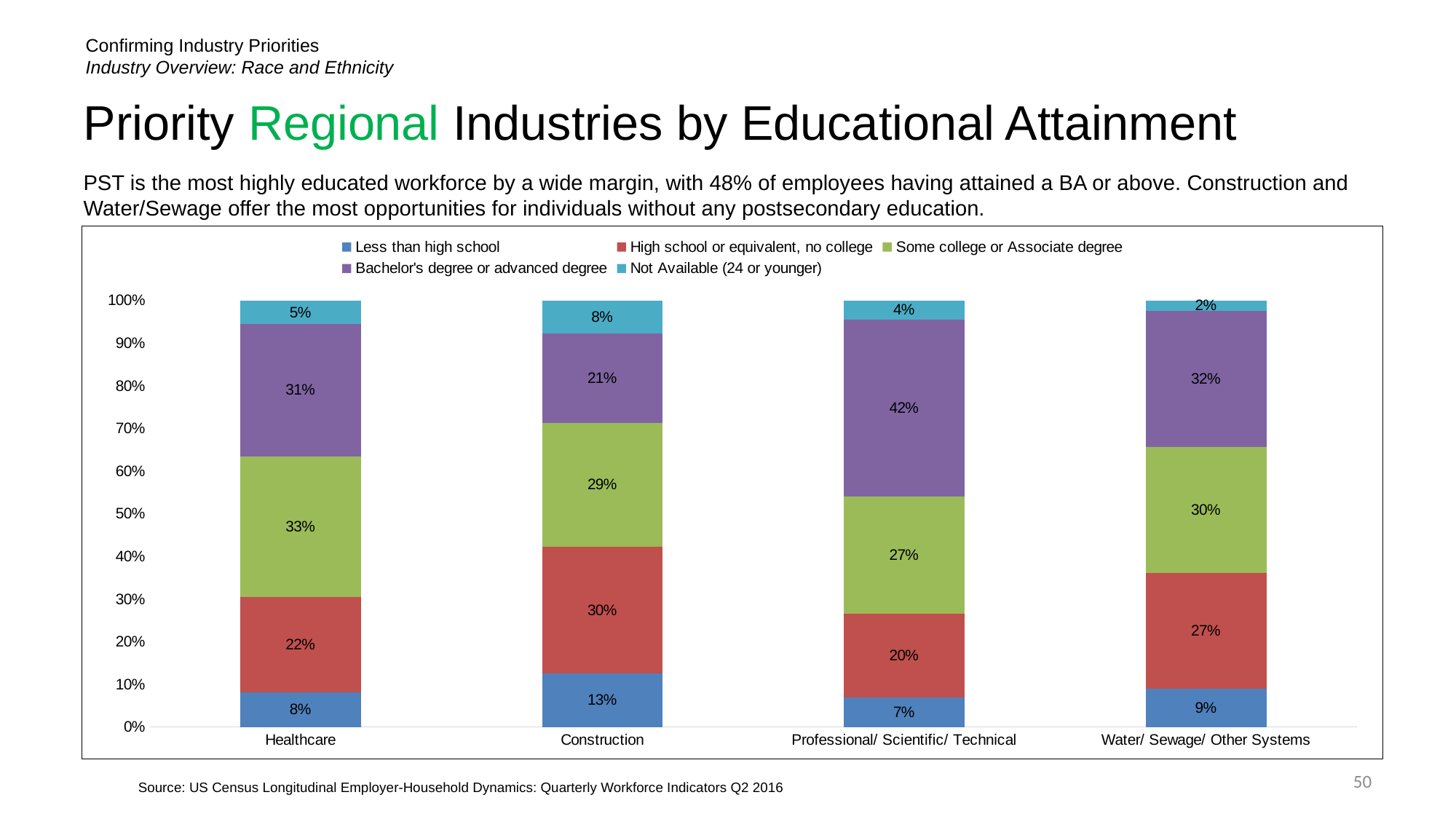
How many series does the legend list? 5 Which industry has the highest share of employees with a Bachelor's degree or advanced degree? Professional/ Scientific/ Technical What share of the Professional/ Scientific/ Technical workforce has Some college or Associate degree? 27% What is the difference between the High school or equivalent, no college share in Construction and in Healthcare? 8% What is the value for Less than high school in Construction? 13% Which colour represents High school or equivalent, no college in the chart? Red What kind of chart is shown on the slide? Stacked bar chart What percentage of the Healthcare workforce has a Bachelor's degree or advanced degree? 31% How many industries are shown on the x axis? 4 What is the Not Available (24 or younger) value for Water/ Sewage/ Other Systems? 2% Which is larger: the Some college or Associate degree share in Healthcare or in Water/ Sewage/ Other Systems? Healthcare Which industry has the lowest share of employees with Less than high school? Professional/ Scientific/ Technical